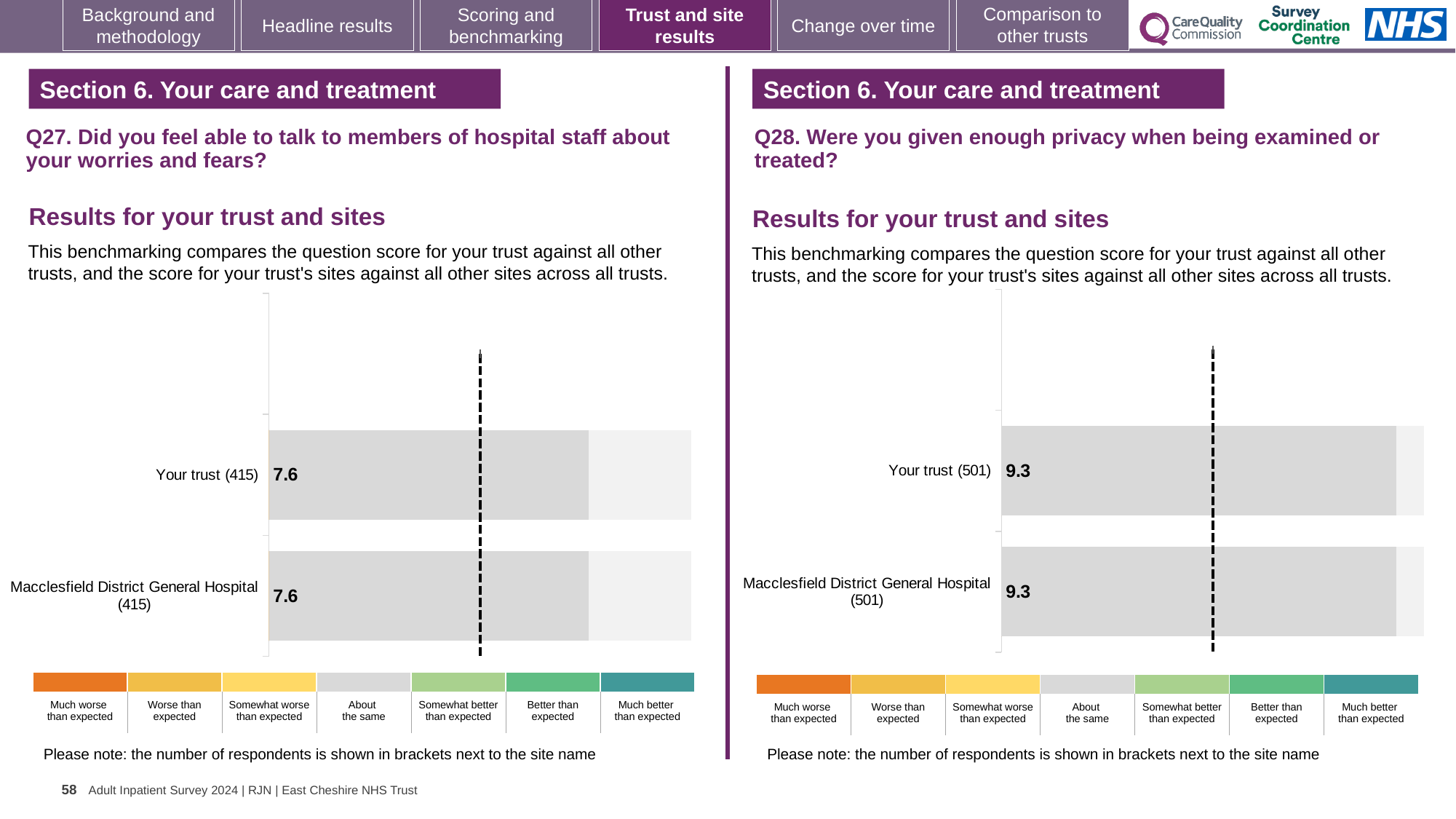
In the Q28 chart on the right, what is the score for Your trust (501)? 9.3 In the Q27 chart on the left, what is the difference between the score for Your trust and the score for Macclesfield District General Hospital? 0 In the Q27 chart on the left, what is the score for Your trust (415)? 7.6 In the Q28 chart on the right, what is the difference between the score for Your trust and the score for Macclesfield District General Hospital? 0 How many bars are plotted in the Q28 chart on the right? 2 How many categories does the colour key below the Q27 chart on the left list? 7 In the Q28 chart on the right, what is the score for Macclesfield District General Hospital (501)? 9.3 How many respondents are shown in brackets for Your trust in the Q28 chart on the right? 501 How many bars are plotted in the Q27 chart on the left? 2 What kind of chart is the Q27 chart on the left? Bar chart In the Q27 chart on the left, what is the score for Macclesfield District General Hospital (415)? 7.6